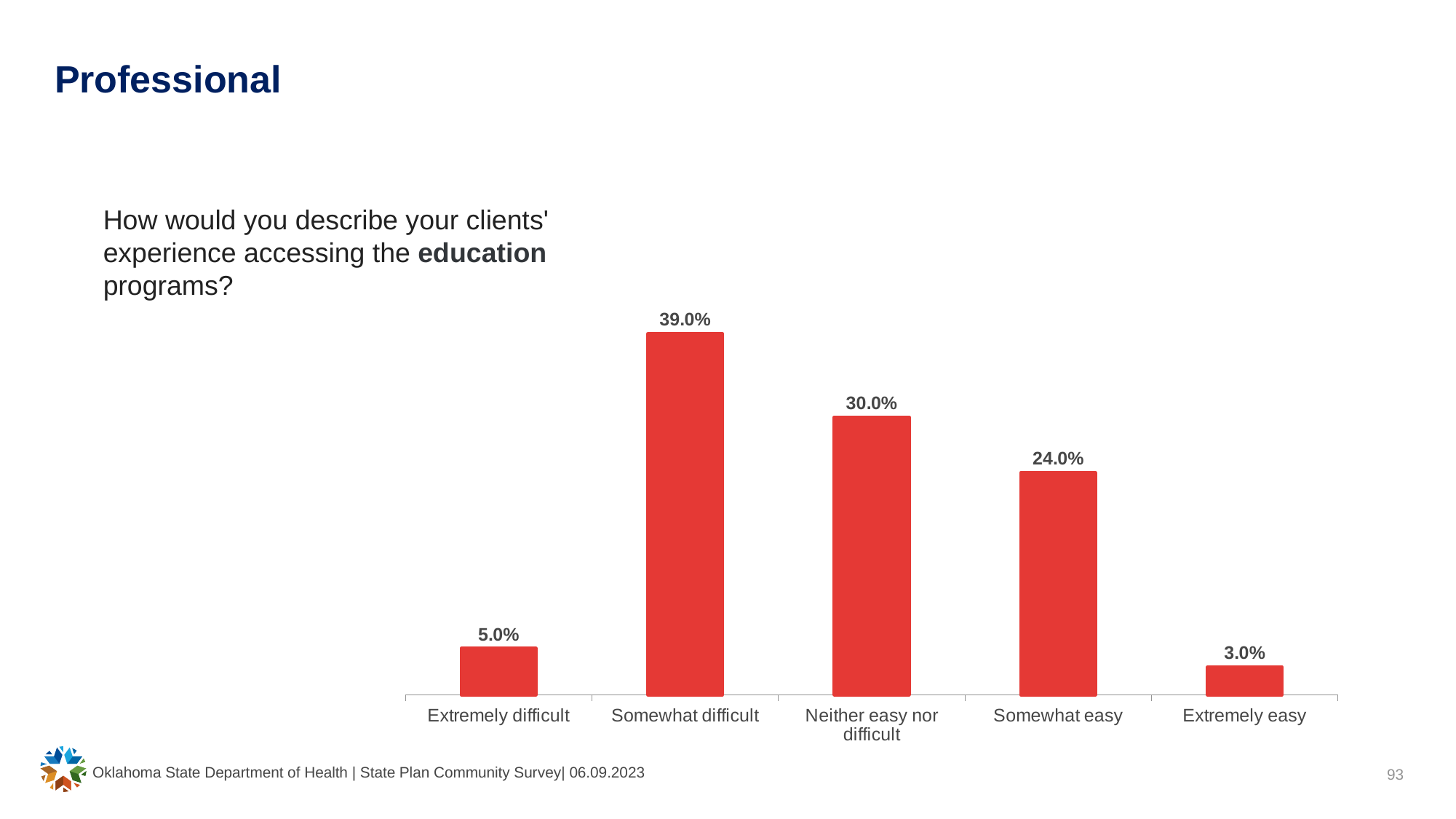
How many categories are shown on the x axis of the chart? 5 What is the difference between the values for 'Extremely difficult' and 'Extremely easy'? 2.0% What colour are the bars in the chart? Red Which is larger, the value for 'Somewhat easy' or the value for 'Neither easy nor difficult'? Neither easy nor difficult Which category has the highest value? Somewhat difficult What percentage of respondents said their clients' experience accessing education programs was 'Somewhat difficult'? 39.0% What is the difference between the values for 'Somewhat difficult' and 'Neither easy nor difficult'? 9.0% What is the value shown for 'Extremely easy'? 3.0% Which category has the lowest value? Extremely easy What kind of chart is shown on the slide? Bar chart What is the value shown for 'Somewhat easy'? 24.0% What is the value shown for 'Neither easy nor difficult'? 30.0%